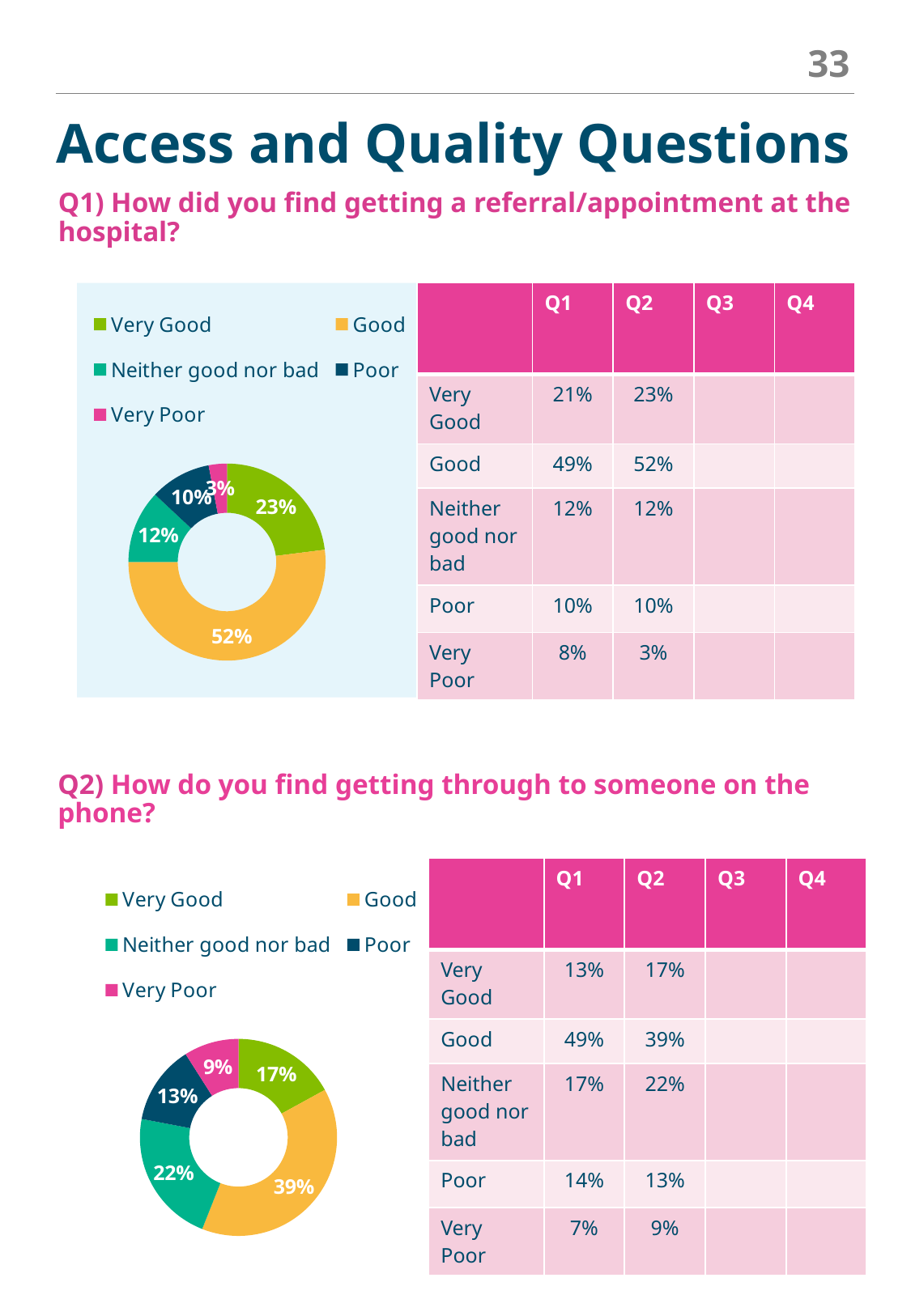
In the top chart (Q1, referral/appointment at the hospital), which category has the smallest share? Very Poor In the bottom chart (Q2, getting through on the phone), what percentage is shown for Very Good? 17% In the bottom chart (Q2, getting through on the phone), which category has the largest share? Good In the top chart (Q1, referral/appointment at the hospital), what percentage is shown for Very Poor? 3% In the bottom chart (Q2, getting through on the phone), which is larger, Poor or Very Poor? Poor How many categories does the legend of the bottom chart (Q2, getting through on the phone) list? 5 In the bottom chart (Q2, getting through on the phone), what is the difference between the Good and Neither good nor bad percentages? 17% In the top chart (Q1, referral/appointment at the hospital), what is the difference between the Very Good and Poor percentages? 13% In the bottom chart (Q2, getting through on the phone), what percentage is shown for Neither good nor bad? 22% In the top chart (Q1, referral/appointment at the hospital), what percentage is shown for Good? 52% In the top chart (Q1, referral/appointment at the hospital), which category has the largest share? Good What kind of chart is used for the Q1 referral/appointment data? Donut chart